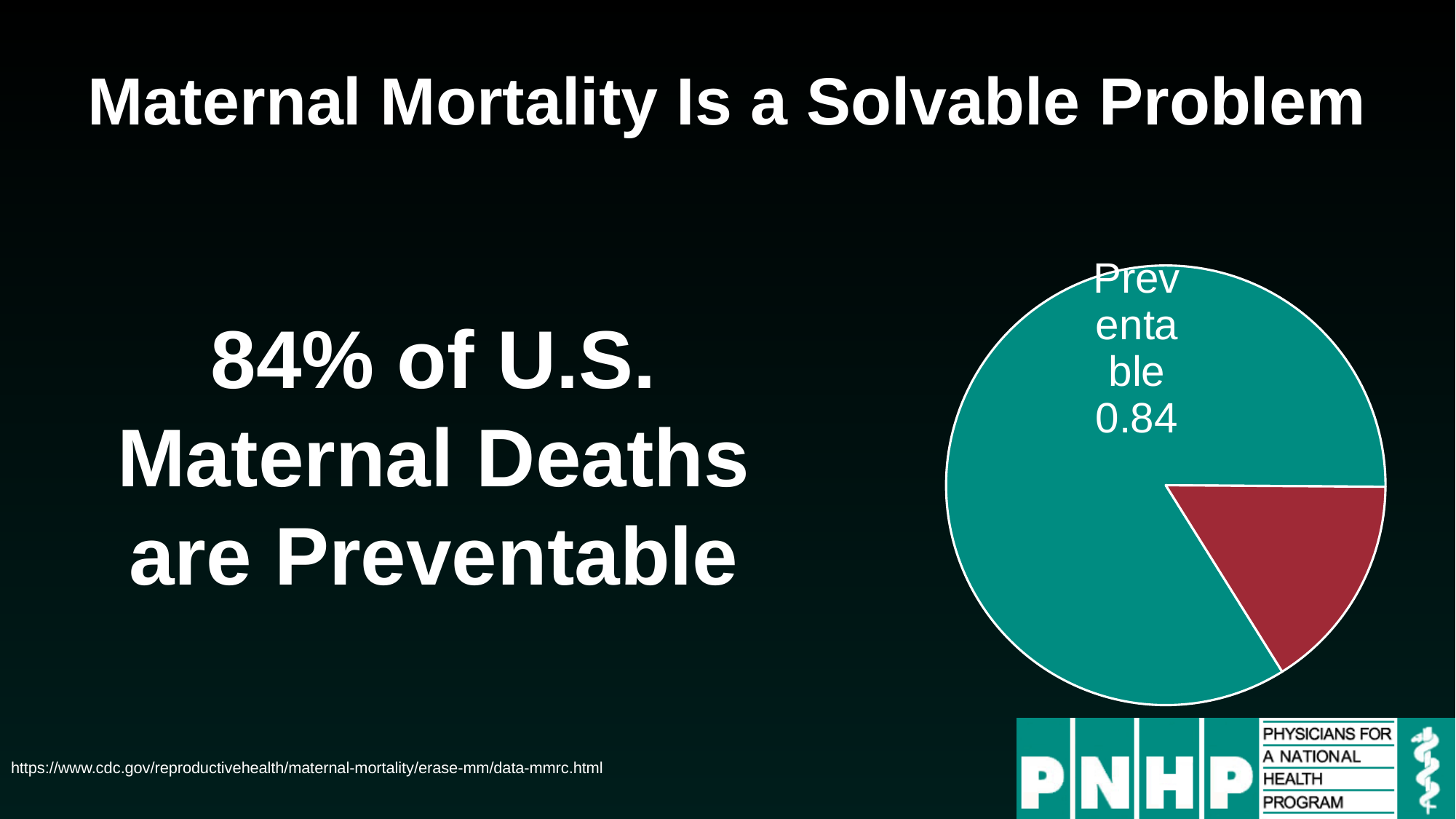
Is the Preventable slice larger or smaller than the red slice? larger What share of the pie does the Preventable slice represent, as printed on the chart? 0.84 What colour is the Preventable slice of the pie chart? teal How many slices of the pie chart have a printed label? 1 Which slice of the pie chart is the largest? Preventable How many slices does the pie chart have? 2 What value is printed on the Preventable slice of the pie chart? 0.84 What kind of chart is shown on the slide? pie chart